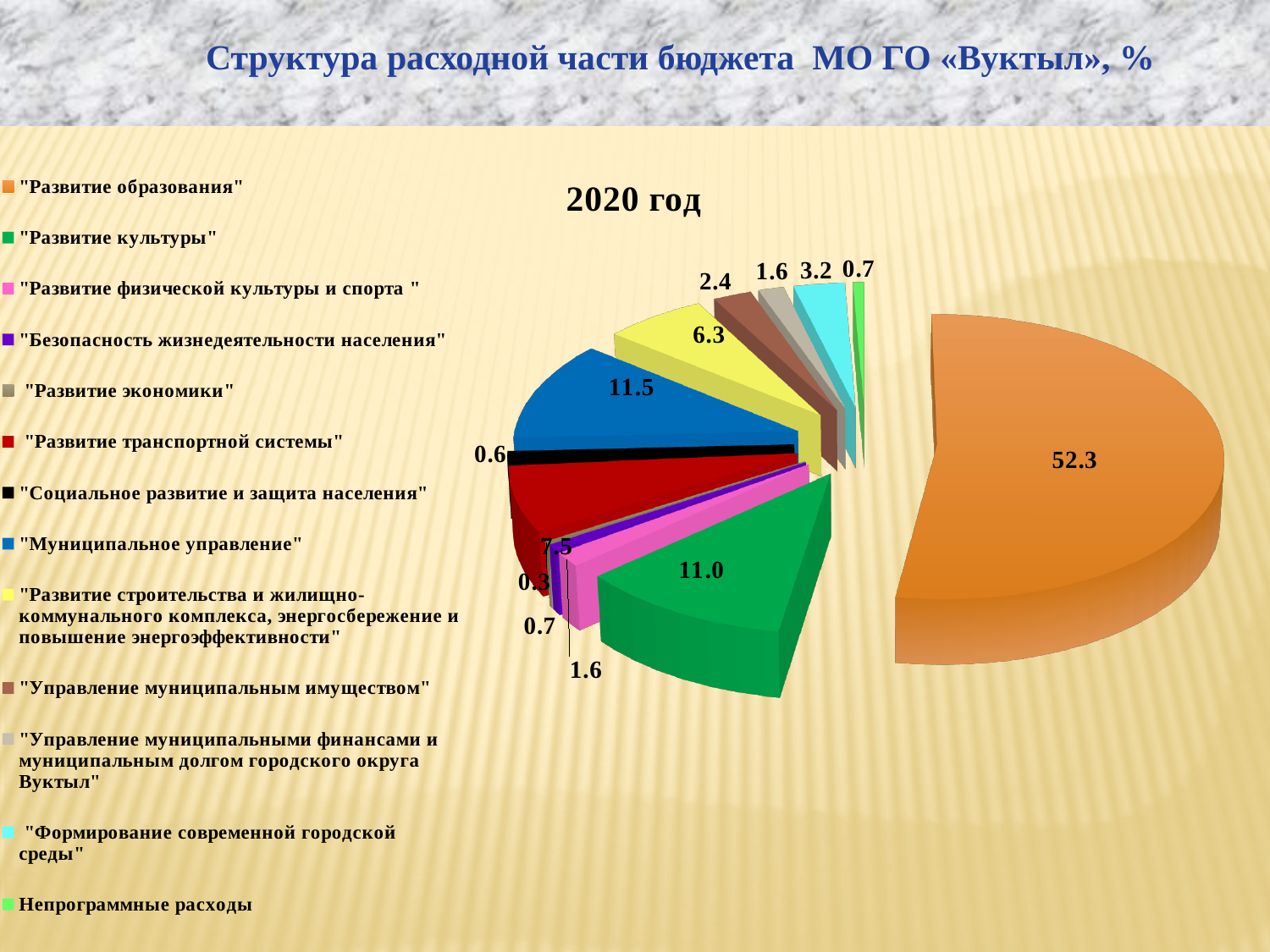
What is the value for "Развитие образования" in the 2020 год pie chart? 52.3 What year is shown in the chart title? 2020 год Which is larger, "Муниципальное управление" or "Развитие культуры"? "Муниципальное управление" What is the value for "Формирование современной городской среды"? 3.2 What is the value for "Развитие транспортной системы"? 7.5 Which category has the largest share of the pie? "Развитие образования" What is the value for "Развитие культуры"? 11.0 What kind of chart is shown on the slide? pie chart What is the value for "Развитие строительства и жилищно-коммунального комплекса, энергосбережение и повышение энергоэффективности"? 6.3 What is the difference between the values for "Развитие образования" and "Развитие культуры"? 41.3 How many categories does the legend list? 13 What is the value for "Муниципальное управление"? 11.5